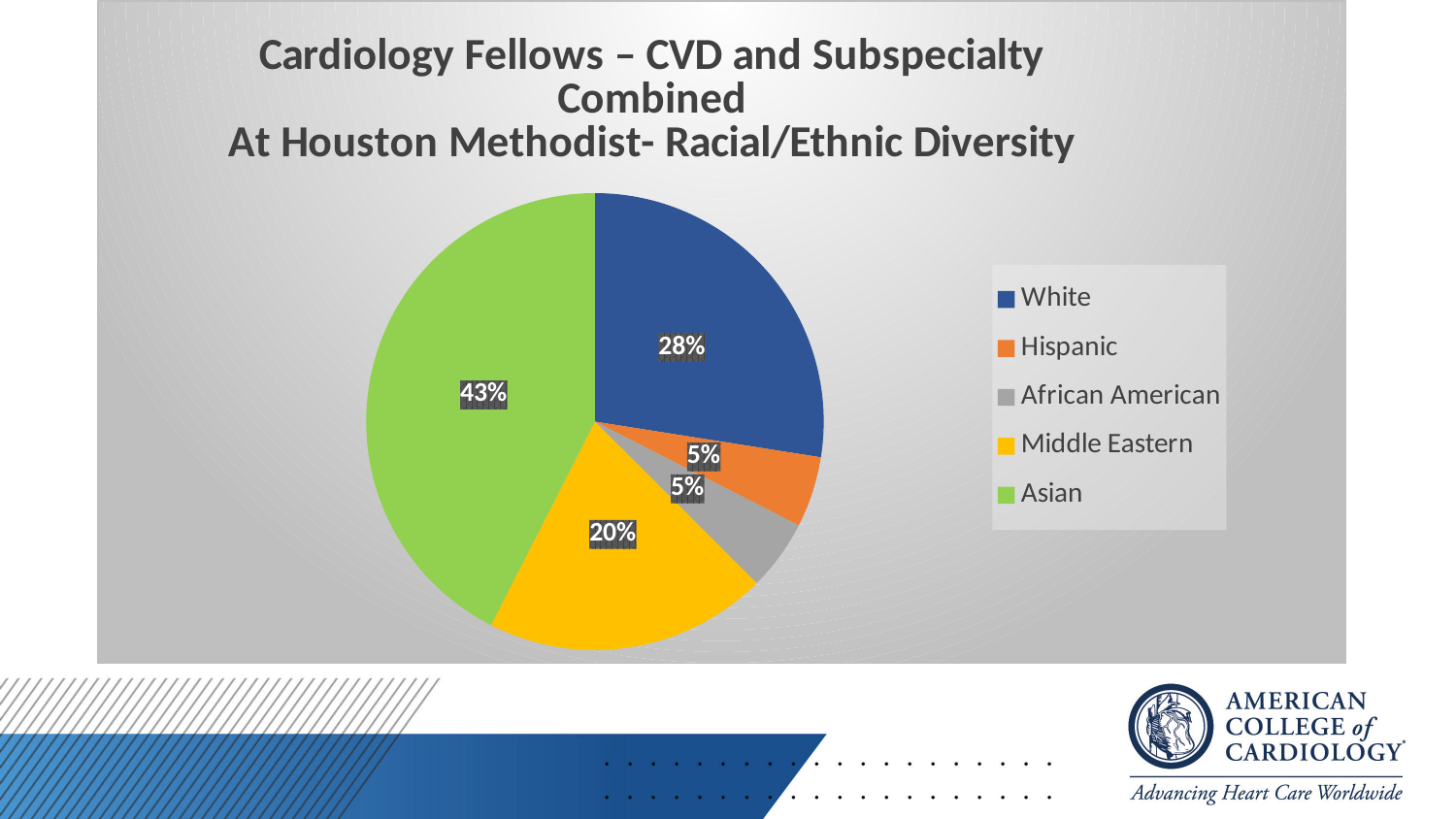
What kind of chart is shown on the slide? pie chart What is the difference in percentage points between the Middle Eastern and African American slices? 15 What is the difference in percentage points between the Asian and White slices? 15 Which category has the largest slice of the pie? Asian What share of the pie is labelled for Hispanic? 5% How many categories does the legend list? 5 What colour is the slice for Middle Eastern? yellow What share of the pie is labelled for Middle Eastern? 20% What share of the pie is labelled for White? 28% Which category is shown in green in the legend? Asian What share of the pie is labelled for Asian? 43% Which slice is larger, Middle Eastern or White? White